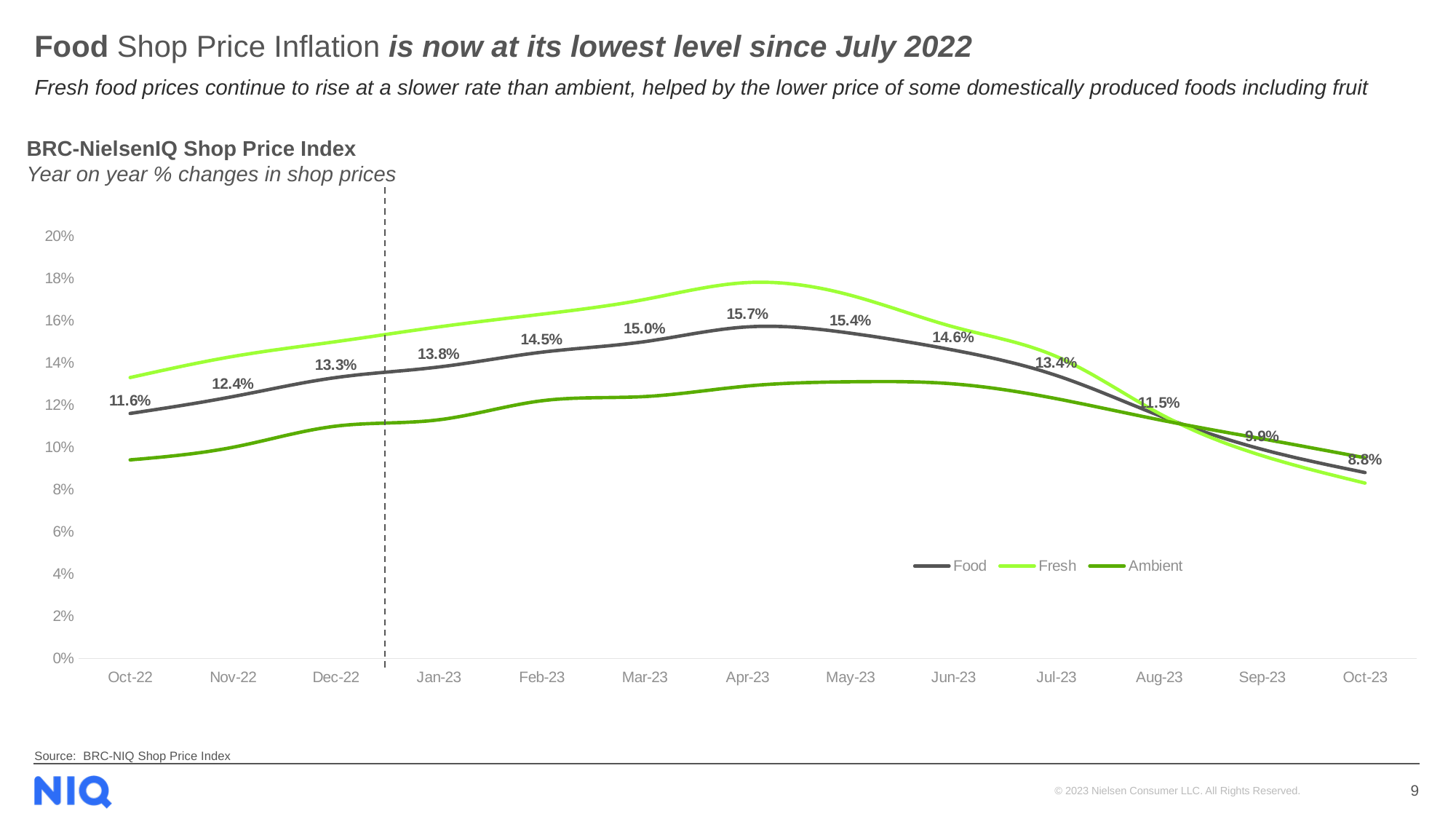
How many series does the legend list? 3 Is the Ambient value for Oct-22 greater or less than 10%? less In which month does the Food series reach its highest value? Apr-23 How many months are shown on the x axis? 13 What is the Food value for Oct-23? 8.8% In which month is the Food series at its lowest value? Oct-23 Which is larger, the Food value for Jun-23 or the Food value for Jul-23? Jun-23 What is the difference between the Food values for Apr-23 and Oct-23? 6.9% What is the Food value for Oct-22? 11.6% What kind of chart is shown on the slide? Line chart What is the Food value for Apr-23? 15.7% Is the Fresh value for Apr-23 greater or less than 16%? greater